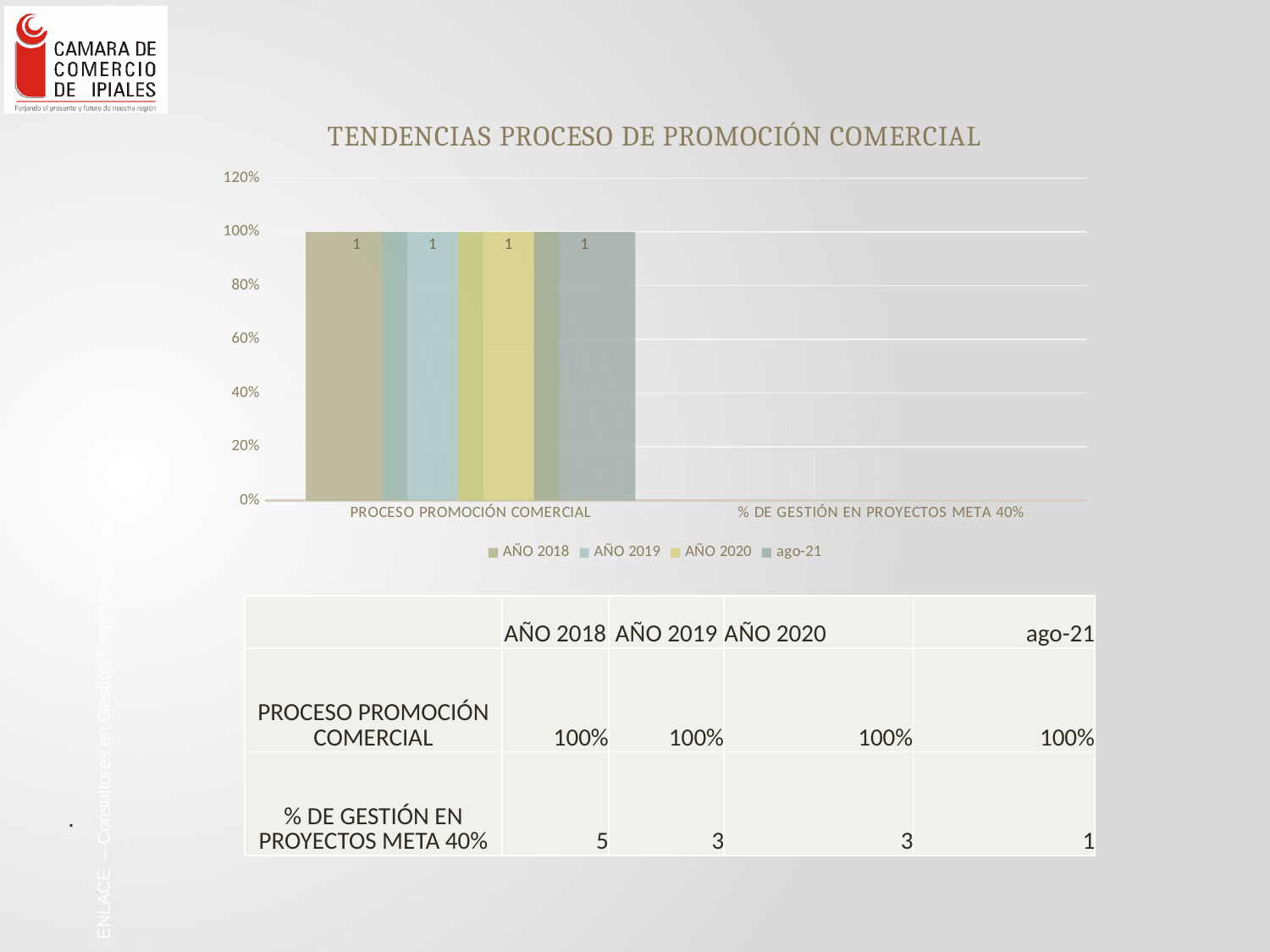
How many series does the chart legend list? 4 Is the AÑO 2020 bar for PROCESO PROMOCIÓN COMERCIAL greater or less than 120%? less What is the highest value shown on the vertical axis of the chart? 120% What data label is printed on the AÑO 2018 bar for PROCESO PROMOCIÓN COMERCIAL? 1 What is the title of the chart? TENDENCIAS PROCESO DE PROMOCIÓN COMERCIAL Is the AÑO 2019 bar for PROCESO PROMOCIÓN COMERCIAL greater or less than 80%? greater Which series is listed last in the chart legend? ago-21 What data label is printed on the ago-21 bar for PROCESO PROMOCIÓN COMERCIAL? 1 Which axis gridline do the bars for PROCESO PROMOCIÓN COMERCIAL reach? 100% What kind of chart is shown on the slide? bar chart How many categories are shown on the x axis of the chart? 2 Do the bar values for PROCESO PROMOCIÓN COMERCIAL rise, fall, or stay the same across the series from AÑO 2018 to ago-21? stay the same